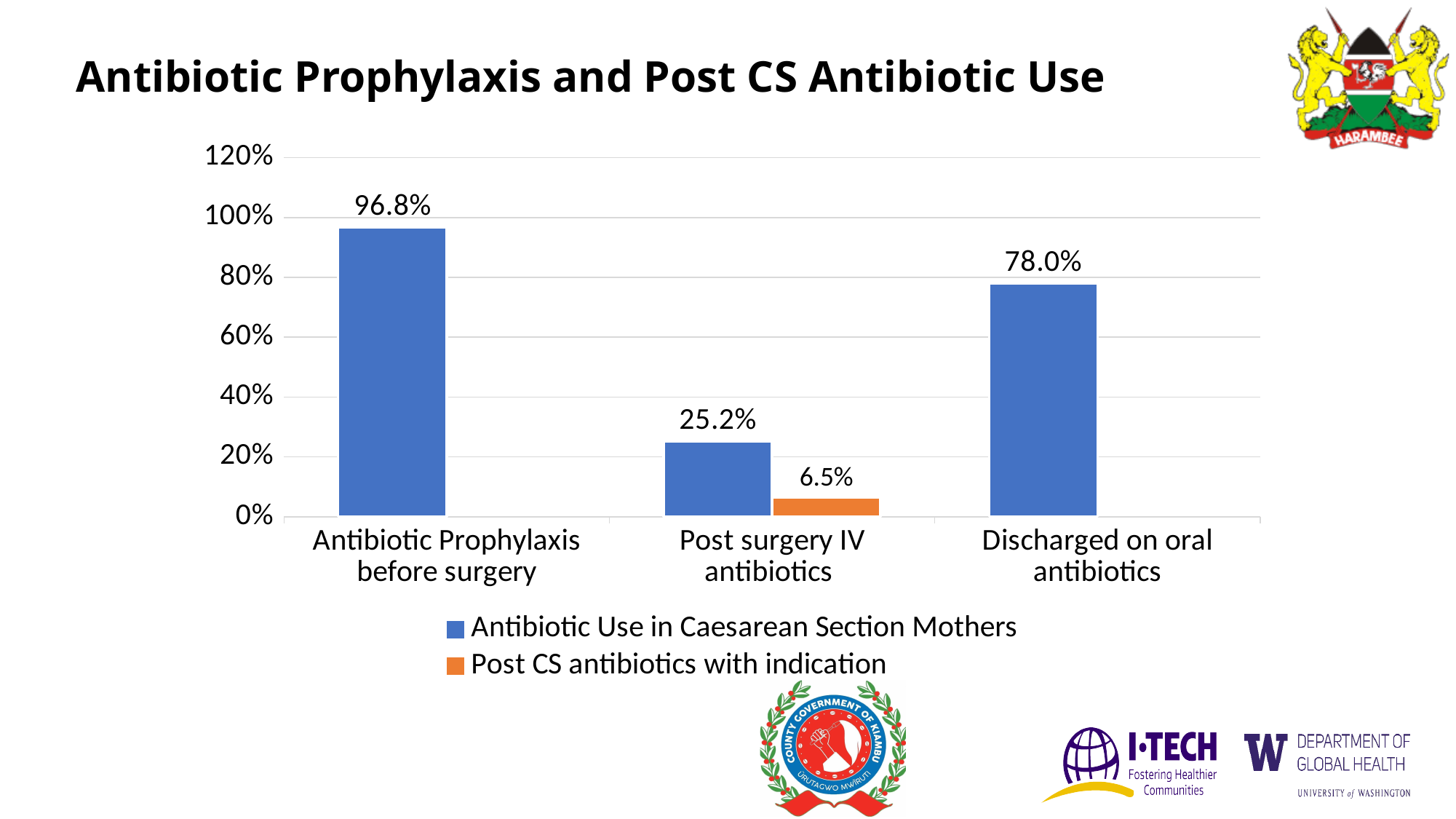
Which is larger: the Discharged on oral antibiotics value or the Post surgery IV antibiotics value in the Antibiotic Use in Caesarean Section Mothers series? Discharged on oral antibiotics Which category has the lowest value in the Antibiotic Use in Caesarean Section Mothers series? Post surgery IV antibiotics What is the value for Discharged on oral antibiotics in the Antibiotic Use in Caesarean Section Mothers series? 78.0% How many series does the legend list? 2 For Post surgery IV antibiotics, what is the difference between the Antibiotic Use in Caesarean Section Mothers value and the Post CS antibiotics with indication value? 18.7% Which category has the highest value in the Antibiotic Use in Caesarean Section Mothers series? Antibiotic Prophylaxis before surgery What is the value for Post surgery IV antibiotics in the Post CS antibiotics with indication series? 6.5% What kind of chart is shown on the slide? Bar chart What is the value for Post surgery IV antibiotics in the Antibiotic Use in Caesarean Section Mothers series? 25.2% What is the difference between the Antibiotic Prophylaxis before surgery value and the Discharged on oral antibiotics value in the Antibiotic Use in Caesarean Section Mothers series? 18.8% What is the value for Antibiotic Prophylaxis before surgery in the Antibiotic Use in Caesarean Section Mothers series? 96.8% How many categories are shown on the x axis? 3